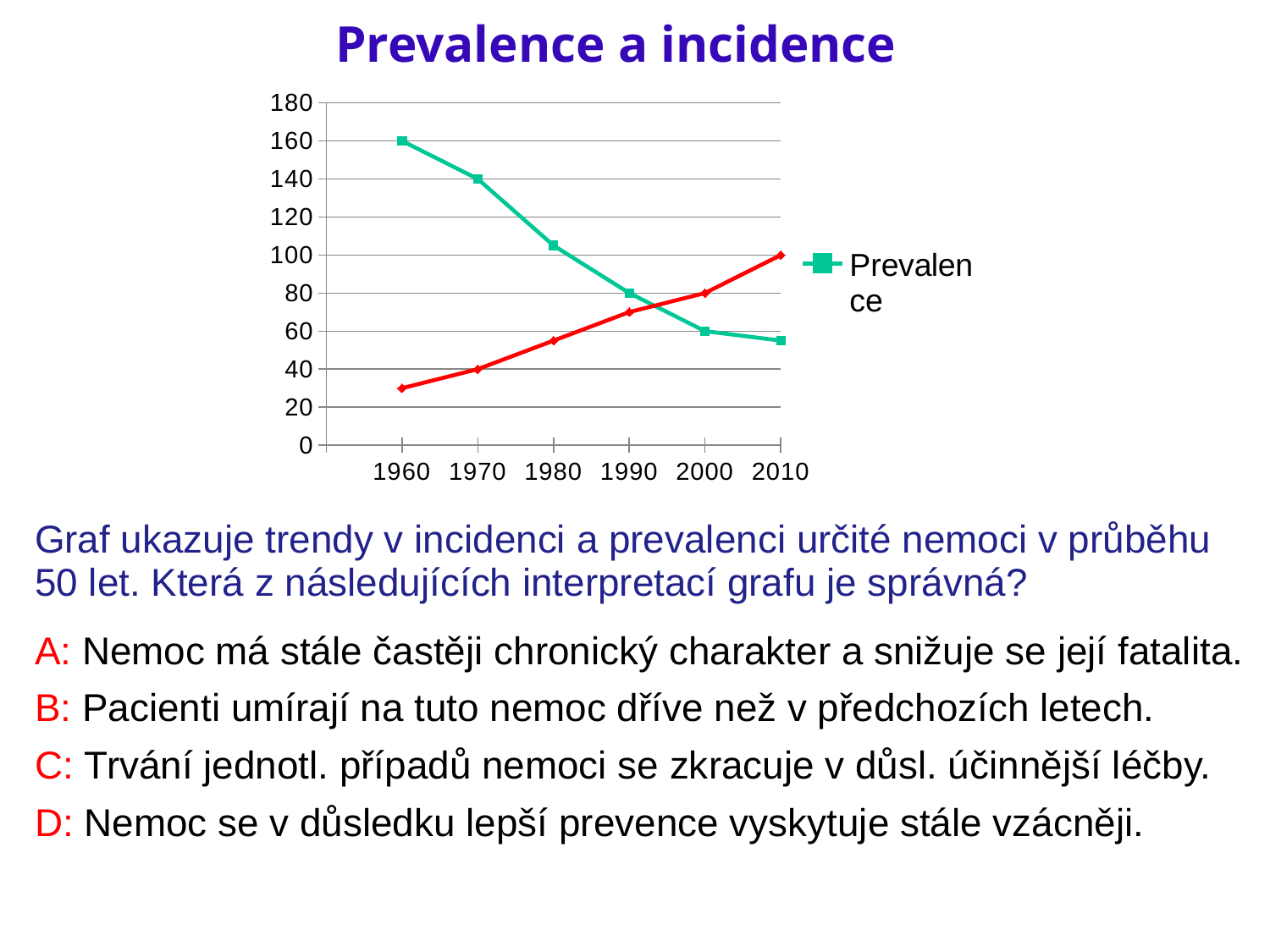
Which year has the larger Prevalence value, 1960 or 2010? 1960 How many series does the chart's legend list? 1 In which year is Prevalence lowest? 2010 What kind of chart is shown on the slide? line chart Does Prevalence rise or fall from 1960 to 2010? fall What is the Prevalence value in 1970? 140 How many years are plotted along the x axis of the chart? 6 In which year is Prevalence highest? 1960 What is the title of the chart? Prevalence a incidence What is the Prevalence value in 1960? 160